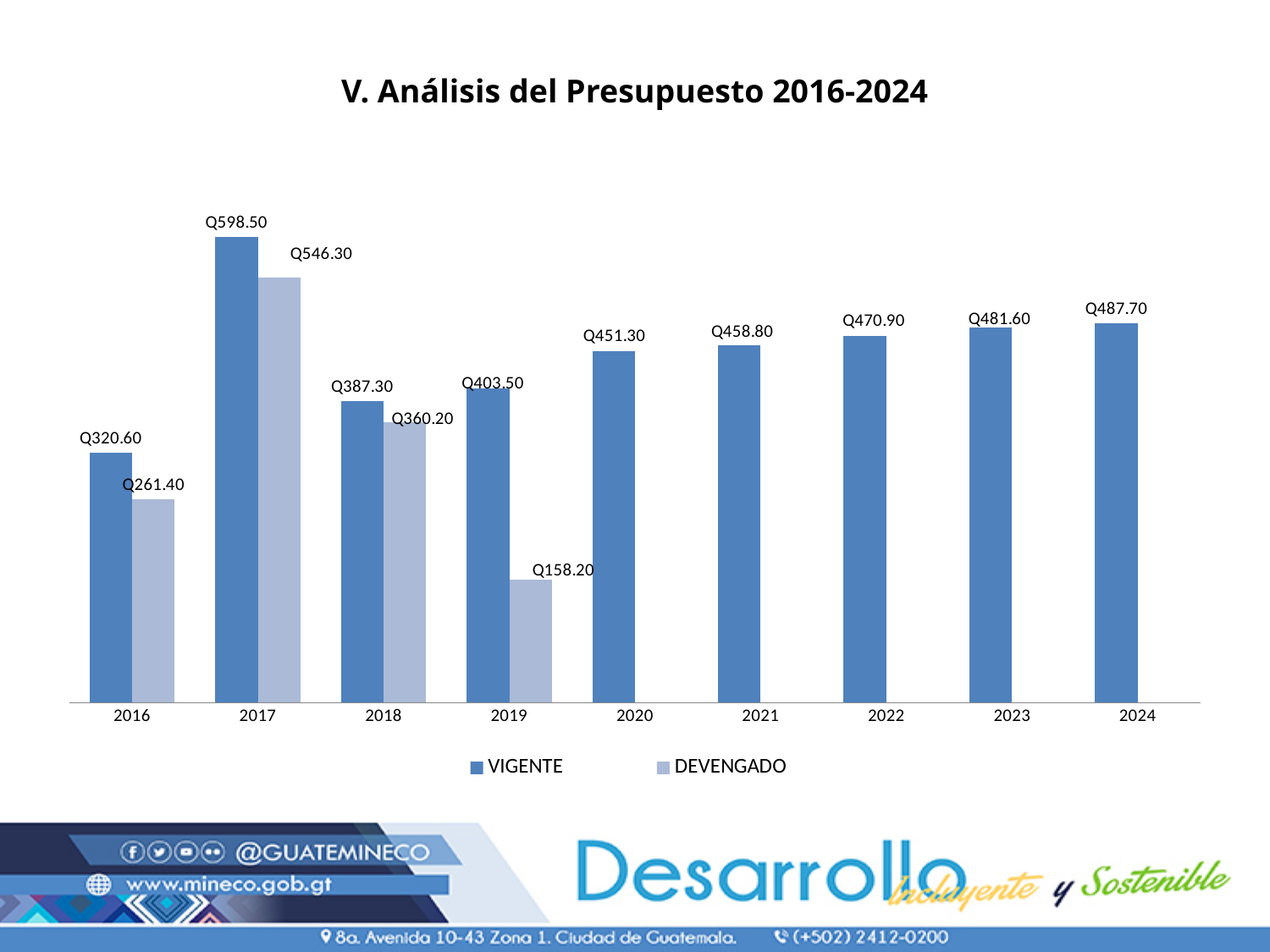
Which year has the lowest DEVENGADO value? 2019 What is the VIGENTE value for 2017? Q598.50 How many series does the legend list? 2 Which year has the lowest VIGENTE value? 2016 What is the DEVENGADO value for 2016? Q261.40 Which year has the highest VIGENTE value? 2017 What is the VIGENTE value for 2024? Q487.70 Which is larger, the VIGENTE value for 2020 or the VIGENTE value for 2019? 2020 What is the DEVENGADO value for 2019? Q158.20 What is the difference between the VIGENTE and DEVENGADO values for 2018? Q27.10 What kind of chart is shown on the slide? Bar chart How many years are shown on the x axis? 9